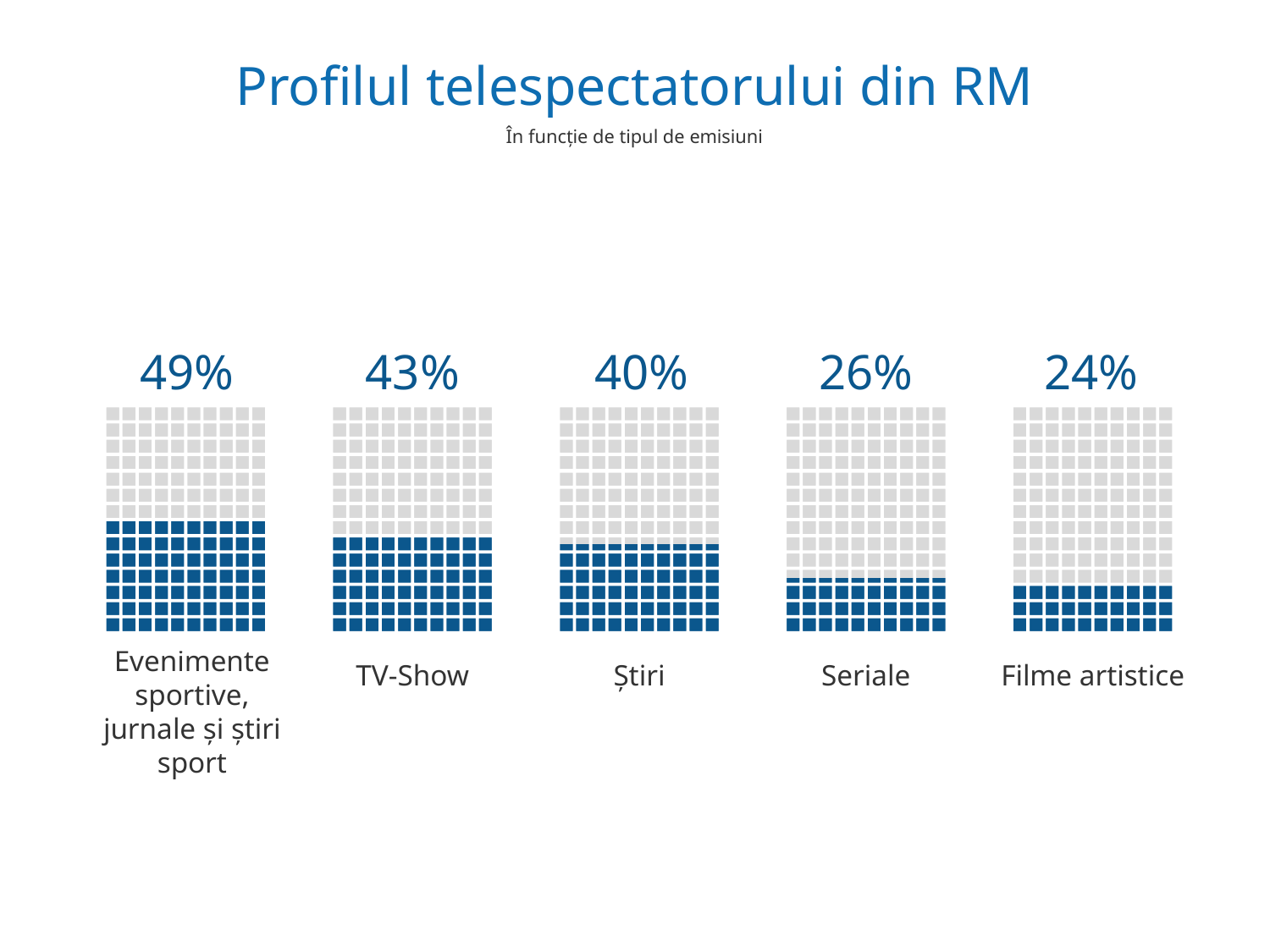
What is the difference between the values for Evenimente sportive, jurnale și știri sport and Filme artistice? 25% What is the value shown for Filme artistice? 24% What is the title of the chart? Profilul telespectatorului din RM What is the value shown for Știri? 40% What kind of chart is shown on the slide? Waffle chart (pictogram grid) What is the value shown for Seriale? 26% How many categories are shown on the chart? 5 Which category has the lowest value? Filme artistice What is the difference between the values for TV-Show and Știri? 3% Which category has the highest value? Evenimente sportive, jurnale și știri sport Which is larger, the value for Seriale or the value for Filme artistice? Seriale What is the value shown for TV-Show? 43%